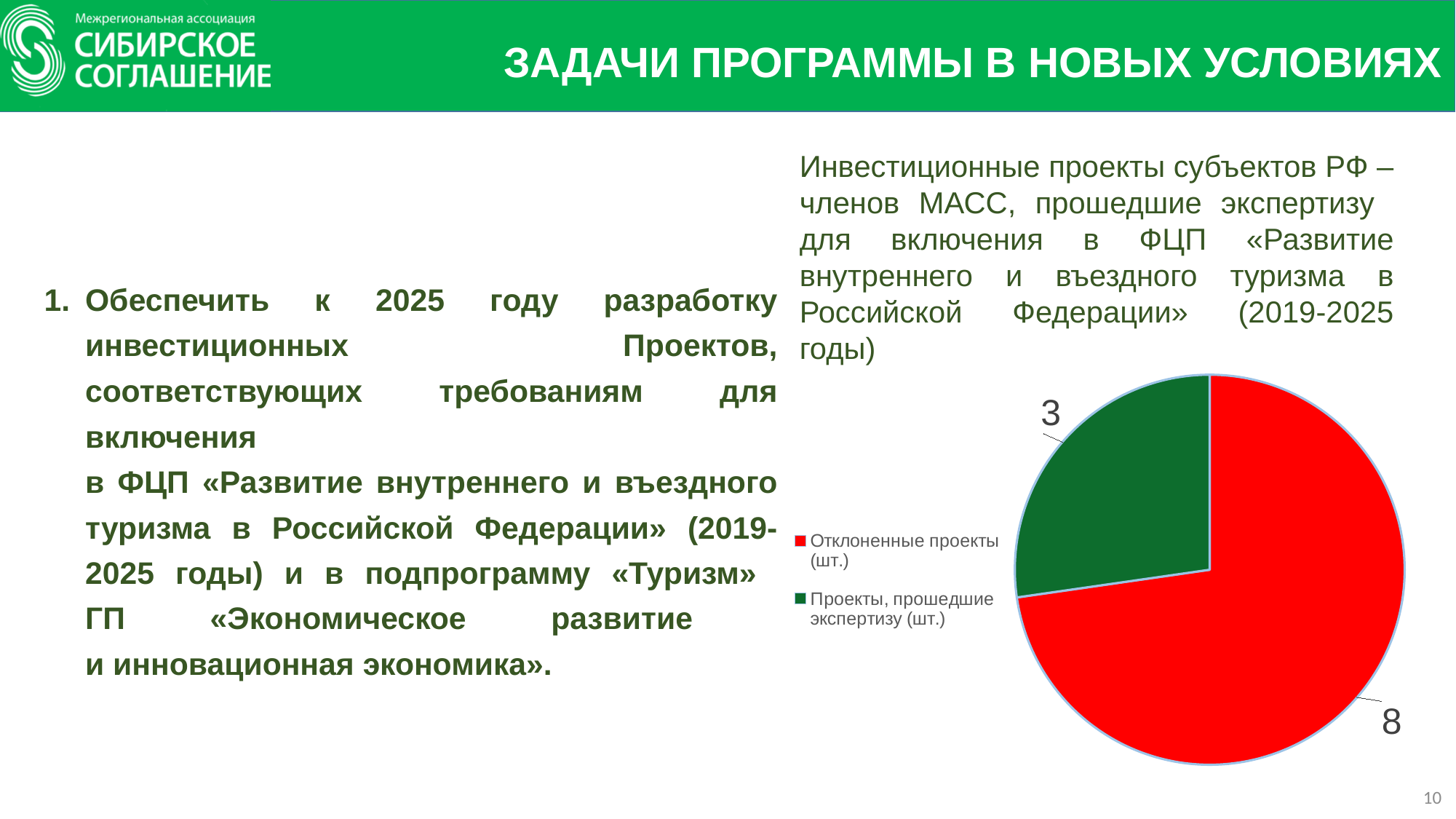
What type of chart is shown on the slide? Pie chart What is the difference between the number of rejected projects and the number of projects that passed the review? 5 Which category has the smallest slice in the pie chart? Проекты, прошедшие экспертизу (шт.) What is the total number of projects shown in the pie chart? 11 How many entries does the legend of the pie chart list? 2 Which category has the largest slice in the pie chart? Отклоненные проекты (шт.) What is the value for «Проекты, прошедшие экспертизу (шт.)» in the pie chart? 3 What is the value for «Отклоненные проекты (шт.)» in the pie chart? 8 How many slices does the pie chart have? 2 What colour is the slice for «Отклоненные проекты (шт.)»? Red What colour is the slice for «Проекты, прошедшие экспертизу (шт.)»? Green Which is larger: the number of rejected projects or the number of projects that passed the review? Отклоненные проекты (шт.)